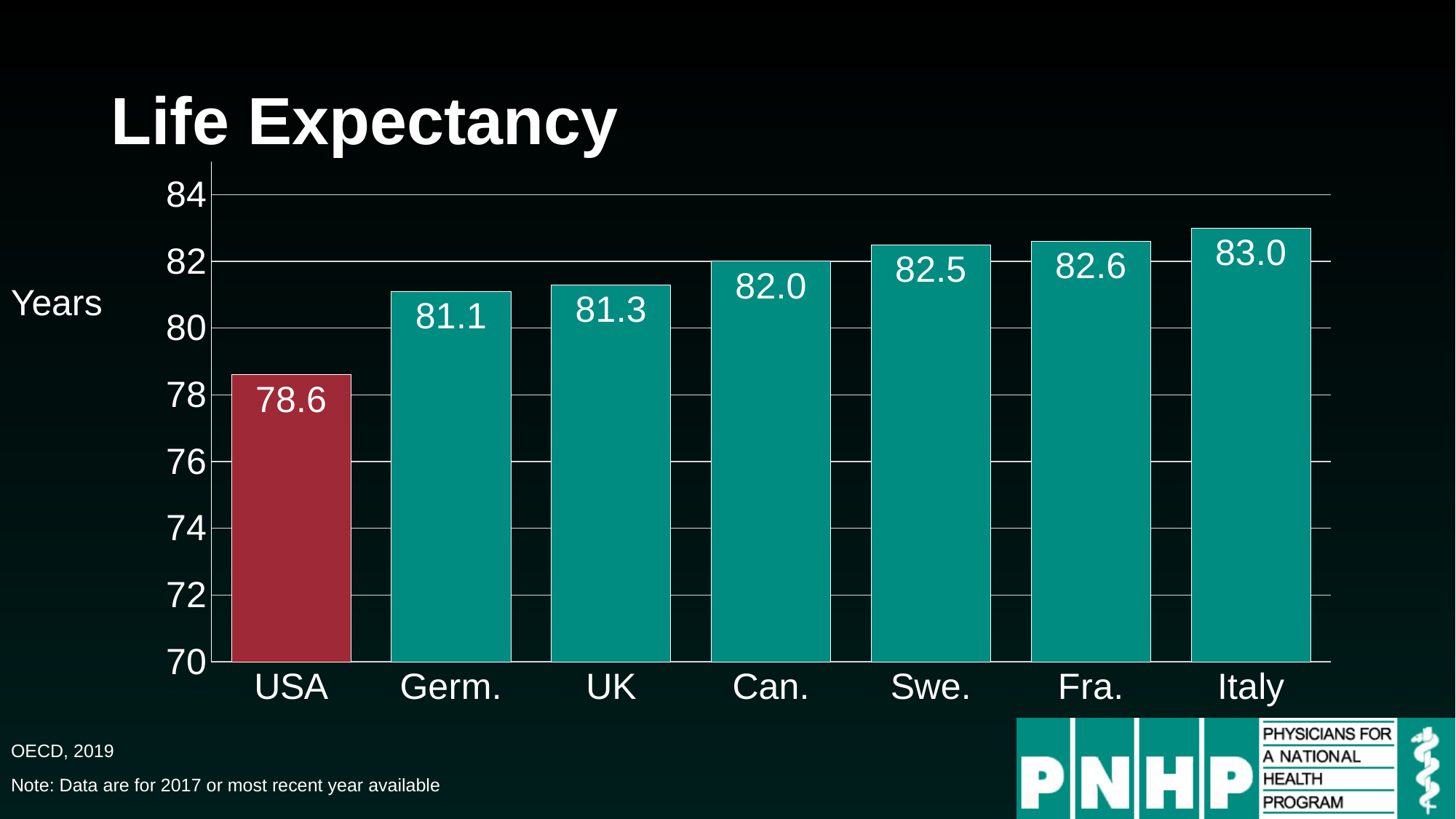
What is the life expectancy value shown for the USA? 78.6 Which country has the highest life expectancy on the chart? Italy What is the difference between the UK's and Germany's life expectancy values? 0.2 What kind of chart is shown on the slide? Bar chart Which has a higher life expectancy, France (Fra.) or Germany (Germ.)? France What is the difference between Italy's and the USA's life expectancy values? 4.4 What is the life expectancy value shown for Canada (Can.)? 82.0 How many countries are shown on the chart? 7 What is the life expectancy value shown for Sweden (Swe.)? 82.5 What is the title of the chart? Life Expectancy Is the value for the USA greater or less than 80? less Which country has the lowest life expectancy on the chart? USA